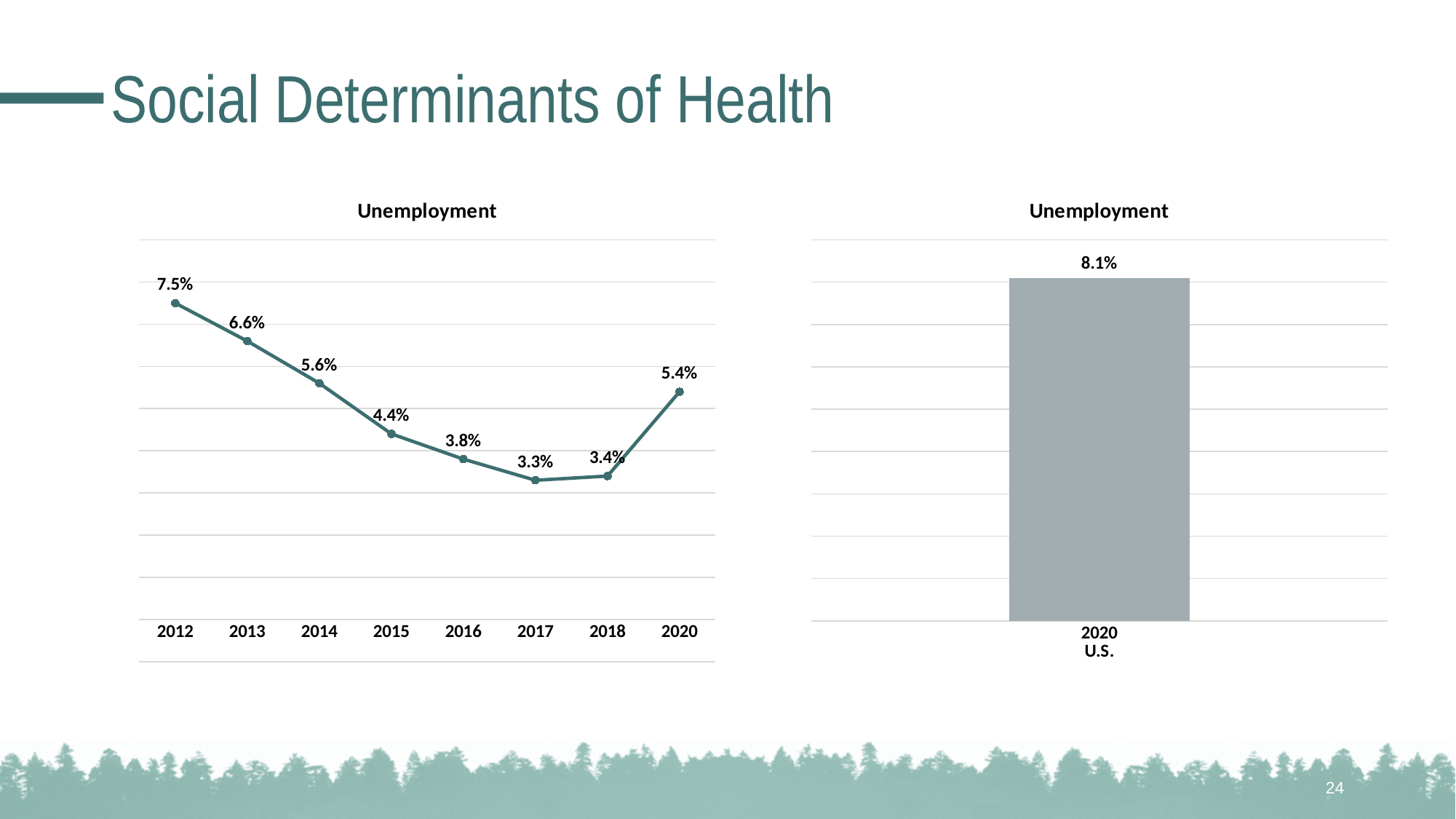
In the left-hand Unemployment line chart, which is larger, the value for 2014 or the value for 2020? 2014 How many years are plotted in the left-hand Unemployment line chart? 8 In the left-hand Unemployment line chart, which year has the highest unemployment rate? 2012 In the left-hand Unemployment line chart, what is the value for 2020? 5.4% In the left-hand Unemployment line chart, what is the difference between the 2012 value and the 2017 value? 4.2% In the left-hand Unemployment line chart, what is the value for 2012? 7.5% What kind of chart is the right-hand Unemployment chart? Bar chart In the left-hand Unemployment line chart, how do the values change from 2012 to 2017? They fall In the right-hand Unemployment chart, what is the value for 2020 U.S.? 8.1% In the left-hand Unemployment line chart, what is the value for 2017? 3.3% In the left-hand Unemployment line chart, which year has the lowest unemployment rate? 2017 What kind of chart is the left-hand Unemployment chart? Line chart